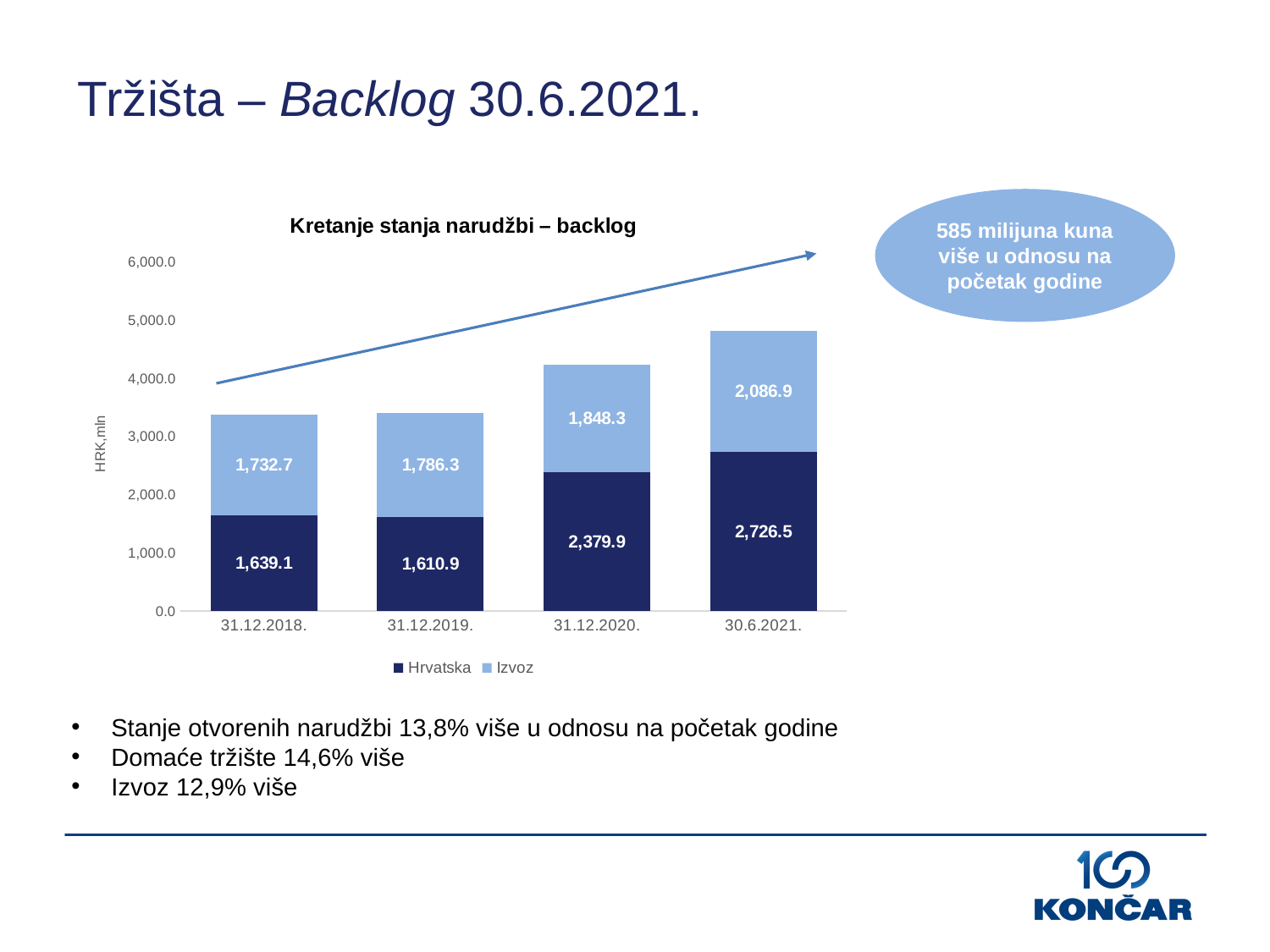
What is the difference between the Izvoz values for 30.6.2021. and 31.12.2020.? 238.6 Which is larger for 31.12.2018., the Hrvatska value or the Izvoz value? Izvoz Which date has the highest Izvoz value? 30.6.2021. How many dates are shown on the x axis? 4 What is the Hrvatska value for 31.12.2020.? 2,379.9 What is the total of the stacked bar for 30.6.2021.? 4,813.4 Which date has the lowest Hrvatska value? 31.12.2019. What is the Izvoz value for 31.12.2019.? 1,786.3 What is the Hrvatska value for 30.6.2021.? 2,726.5 How many series does the legend list? 2 What kind of chart is shown? Stacked bar chart What is the total of the stacked bar for 31.12.2018.? 3,371.8